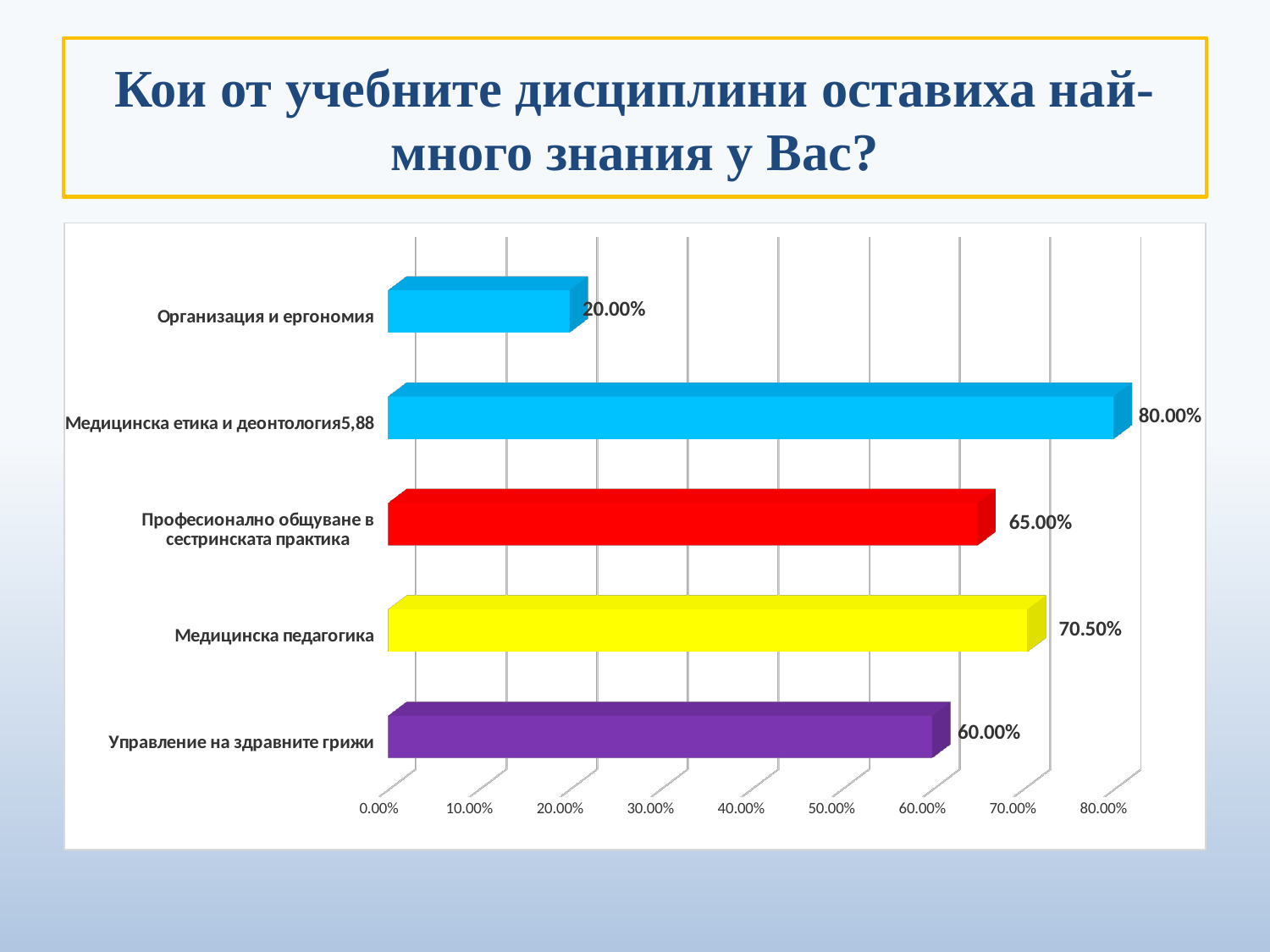
What kind of chart is shown on the slide? Bar chart What is the value for Професионално общуване в сестринската практика? 65.00% What is the value for Управление на здравните грижи? 60.00% What is the value for Организация и ергономия? 20.00% What colour is the bar for Управление на здравните грижи? Purple Which category has the highest value? Медицинска етика и деонтология What is the difference between the values for Медицинска педагогика and Управление на здравните грижи? 10.50% What is the difference between the values for Медицинска етика и деонтология and Организация и ергономия? 60.00% How many categories are shown in the chart? 5 What is the value for Медицинска педагогика? 70.50% Which category has the lowest value? Организация и ергономия Which is larger, the value for Професионално общуване в сестринската практика or the value for Медицинска педагогика? Медицинска педагогика